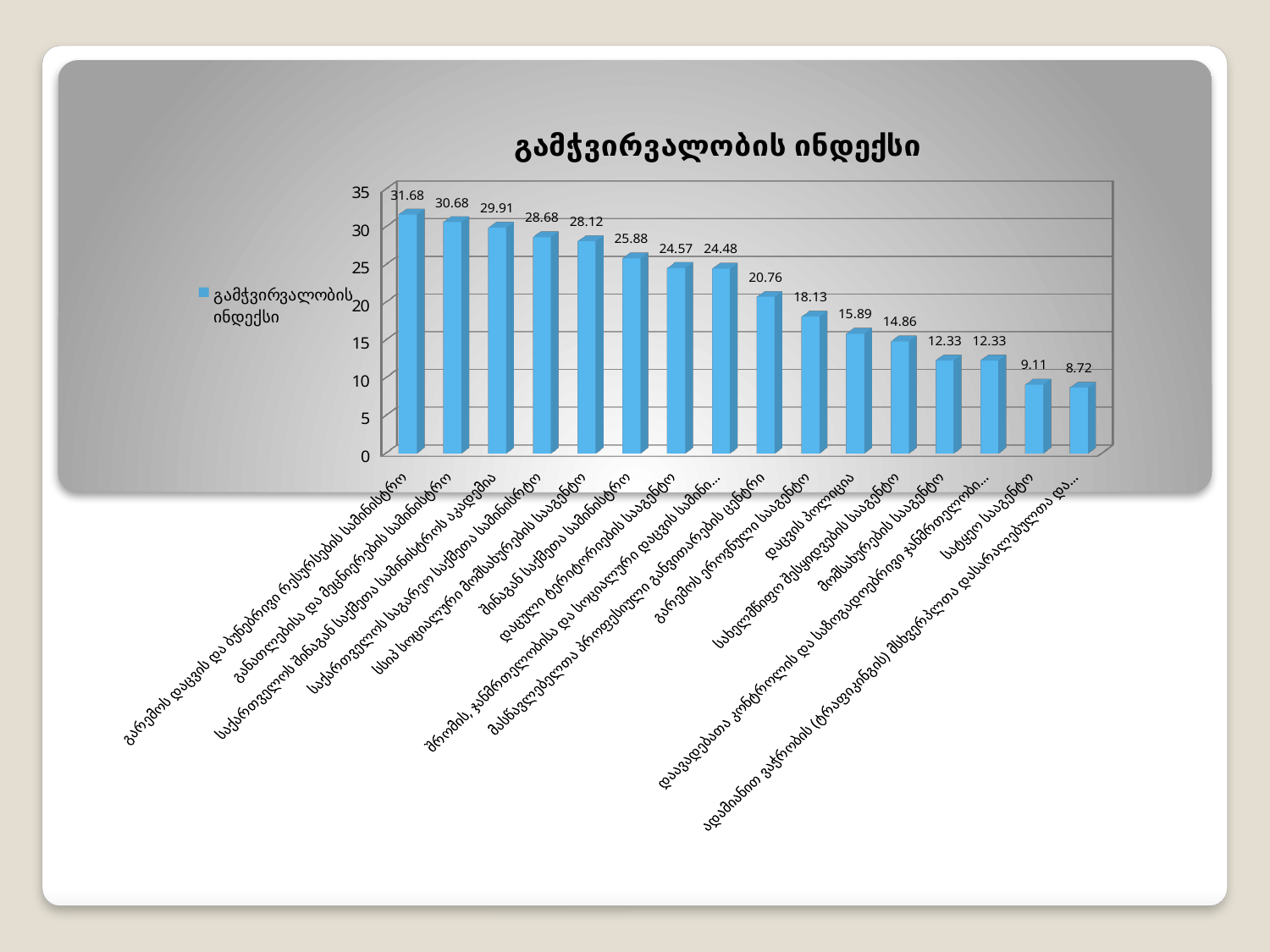
How many series does the legend list? 1 Which category has the highest value? გარემოს დაცვის და ბუნებრივი რესურსების სამინისტრო What is the value for განათლების და მეცნიერების სამინისტრო? 30.68 Do the values rise or fall from left to right along the x axis? fall How many bars (categories) are plotted in the chart? 16 What is the title of the chart? გამჭვირვალობის ინდექსი What is the value for სატყეო სააგენტო? 9.11 What is the difference between the highest value (31.68) and the lowest value (8.72)? 22.96 What is the value for დაცვის პოლიცია? 15.89 What is the value for შინაგან საქმეთა სამინისტრო? 25.88 What type of chart is shown on the slide? bar chart Which is larger: the value for გარემოს ეროვნული სააგენტო or the value for სახელმწიფო შესყიდვების სააგენტო? გარემოს ეროვნული სააგენტო